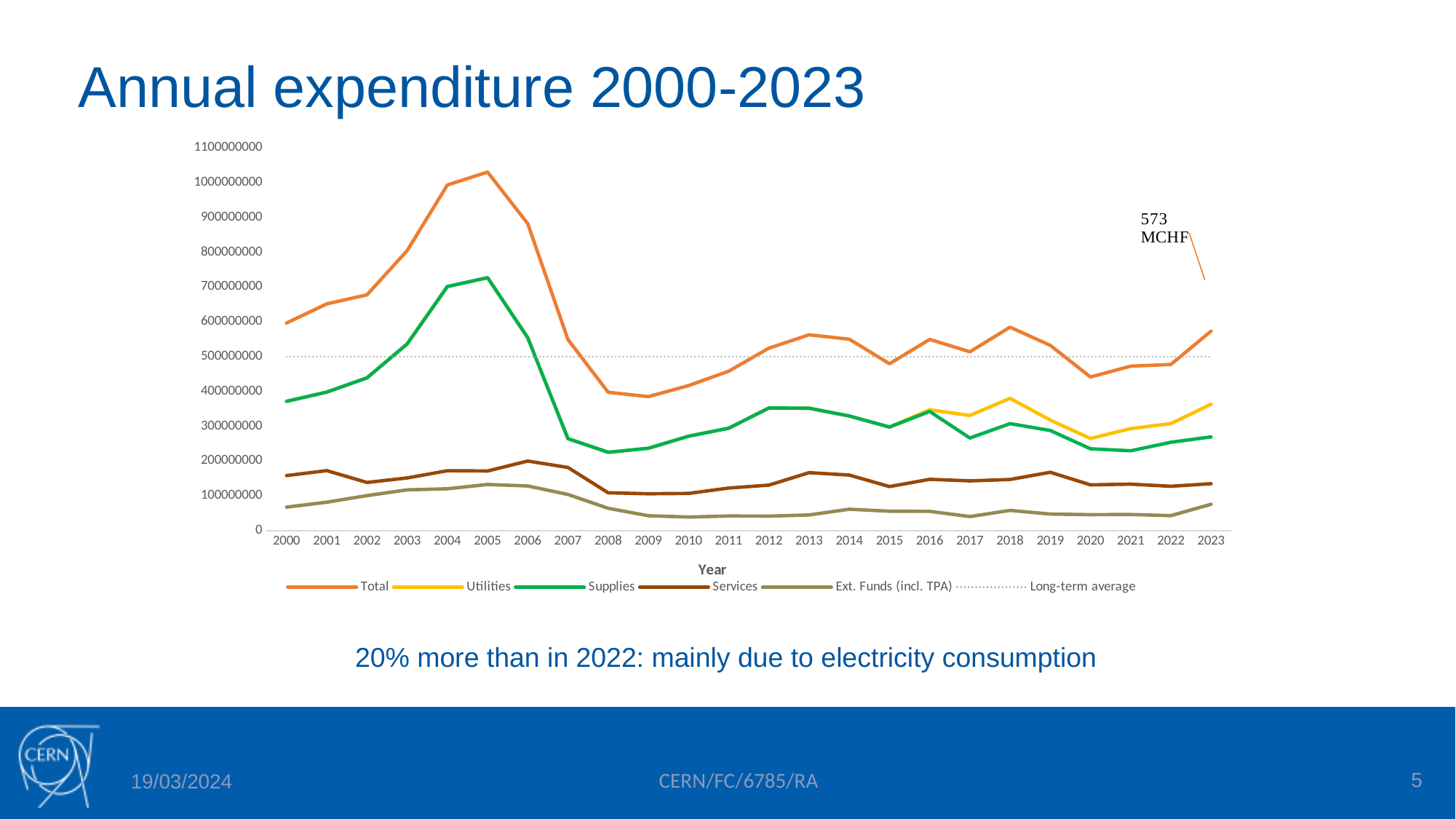
Is the value for Total in 2005 greater or less than 1000000000? greater Which series has the lowest value in 2023? Ext. Funds (incl. TPA) In 2005, which is larger: Supplies or Services? Supplies How many series does the legend list? 6 Is the value for Total in 2020 greater or less than 500000000? less What kind of chart is shown on the slide? line chart In which year does the Total series reach its highest value? 2005 Is the value for Supplies in 2008 greater or less than 300000000? less In 2018, which is larger: Utilities or Supplies? Utilities How many years are plotted along the x axis? 24 Does the Total series rise or fall between 2005 and 2008? fall What value is annotated for the Total series in 2023? 573 MCHF